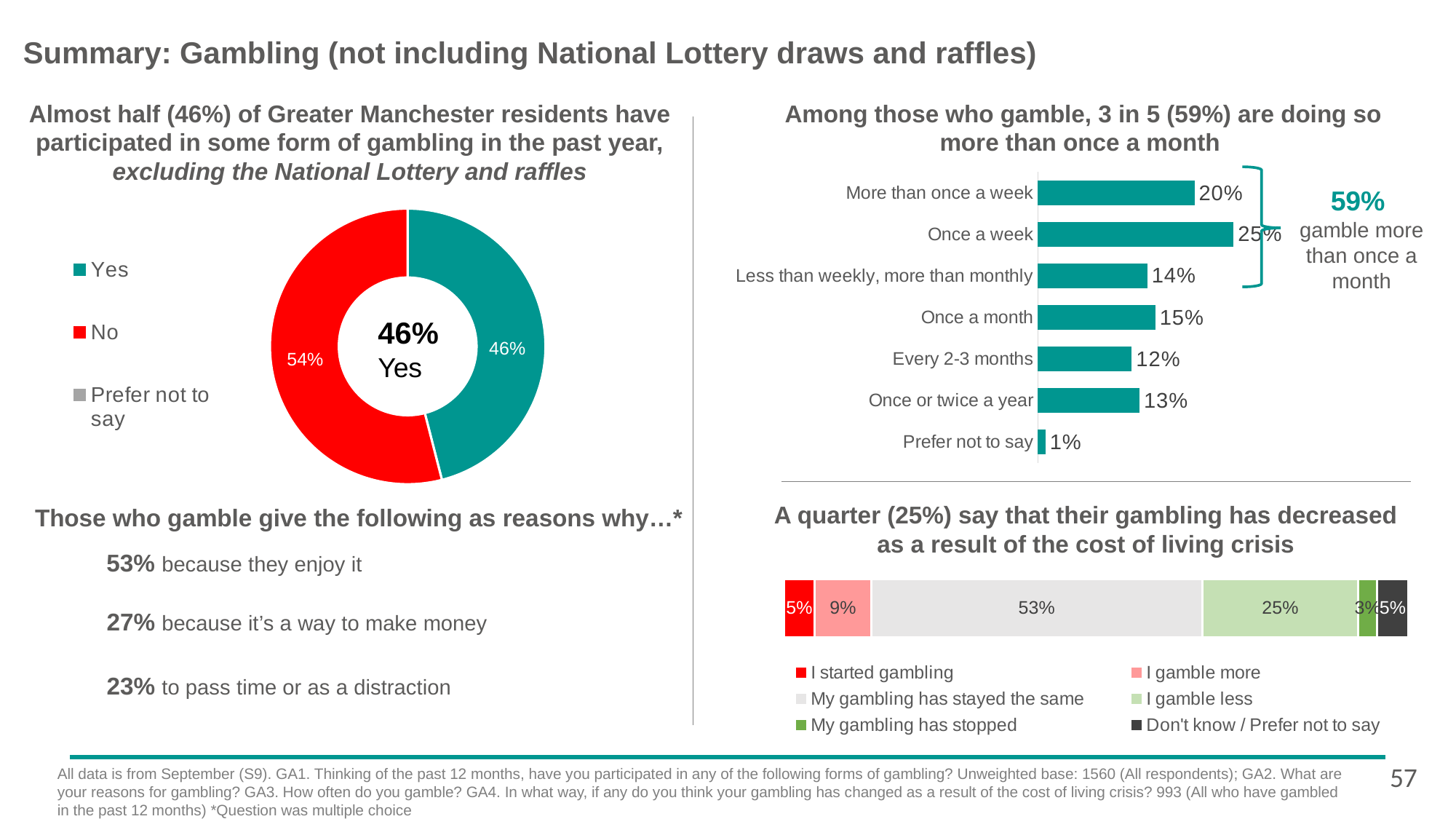
In the bar chart 'Among those who gamble, 3 in 5 (59%) are doing so more than once a month', which category has the lowest value? Prefer not to say In the bar chart 'Among those who gamble, 3 in 5 (59%) are doing so more than once a month', what is the value for 'Once a week'? 25% How many categories are shown in the bar chart 'Among those who gamble, 3 in 5 (59%) are doing so more than once a month'? 7 In the donut chart on the left, what percentage answered No? 54% How many entries does the legend of the donut chart on the left list? 3 In the donut chart on the left, what percentage of Greater Manchester residents answered Yes to having participated in gambling in the past year? 46% How many entries does the legend of the stacked bar chart 'A quarter (25%) say that their gambling has decreased as a result of the cost of living crisis' list? 6 In the bar chart 'Among those who gamble, 3 in 5 (59%) are doing so more than once a month', which category has the highest value? Once a week What kind of chart is used on the left to show the share of residents who have gambled in the past year? Pie (donut) chart In the bar chart 'Among those who gamble, 3 in 5 (59%) are doing so more than once a month', which is larger: 'Once a month' or 'Every 2-3 months'? Once a month In the stacked bar chart 'A quarter (25%) say that their gambling has decreased as a result of the cost of living crisis', what is the value for 'I gamble less'? 25% In the bar chart 'Among those who gamble, 3 in 5 (59%) are doing so more than once a month', what is the difference between 'Once a week' and 'More than once a week'? 5 percentage points